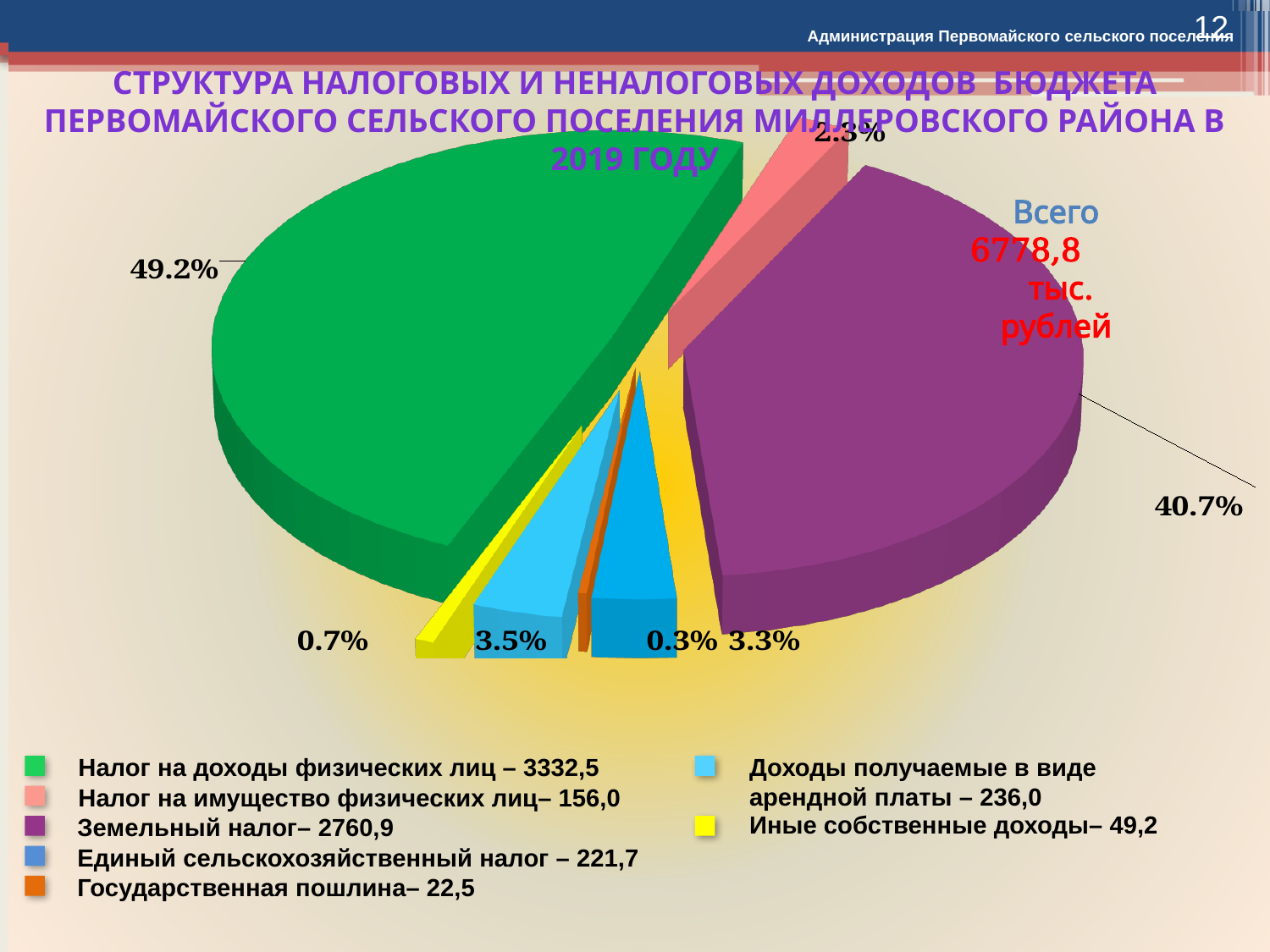
What share of the pie does Налог на имущество физических лиц (the pink slice) represent? 2.3% What total amount (Всего) is shown next to the pie chart? 6778,8 тыс. рублей What is the difference in percentage points between the share of Налог на доходы физических лиц (49.2%) and Земельный налог (40.7%)? 8.5 Which category has the smallest share of the pie? Государственная пошлина Which is larger: the share of Доходы получаемые в виде арендной платы or the share of Иные собственные доходы? Доходы получаемые в виде арендной платы What is the value listed for Доходы получаемые в виде арендной платы? 236,0 Which category has the largest share of the pie? Налог на доходы физических лиц What share of the pie does Налог на доходы физических лиц (the green slice) represent? 49.2% What is the value listed for Единый сельскохозяйственный налог? 221,7 What kind of chart is shown on the slide? Pie chart How many slices does the pie chart have? 7 What share of the pie does Земельный налог (the purple slice) represent? 40.7%